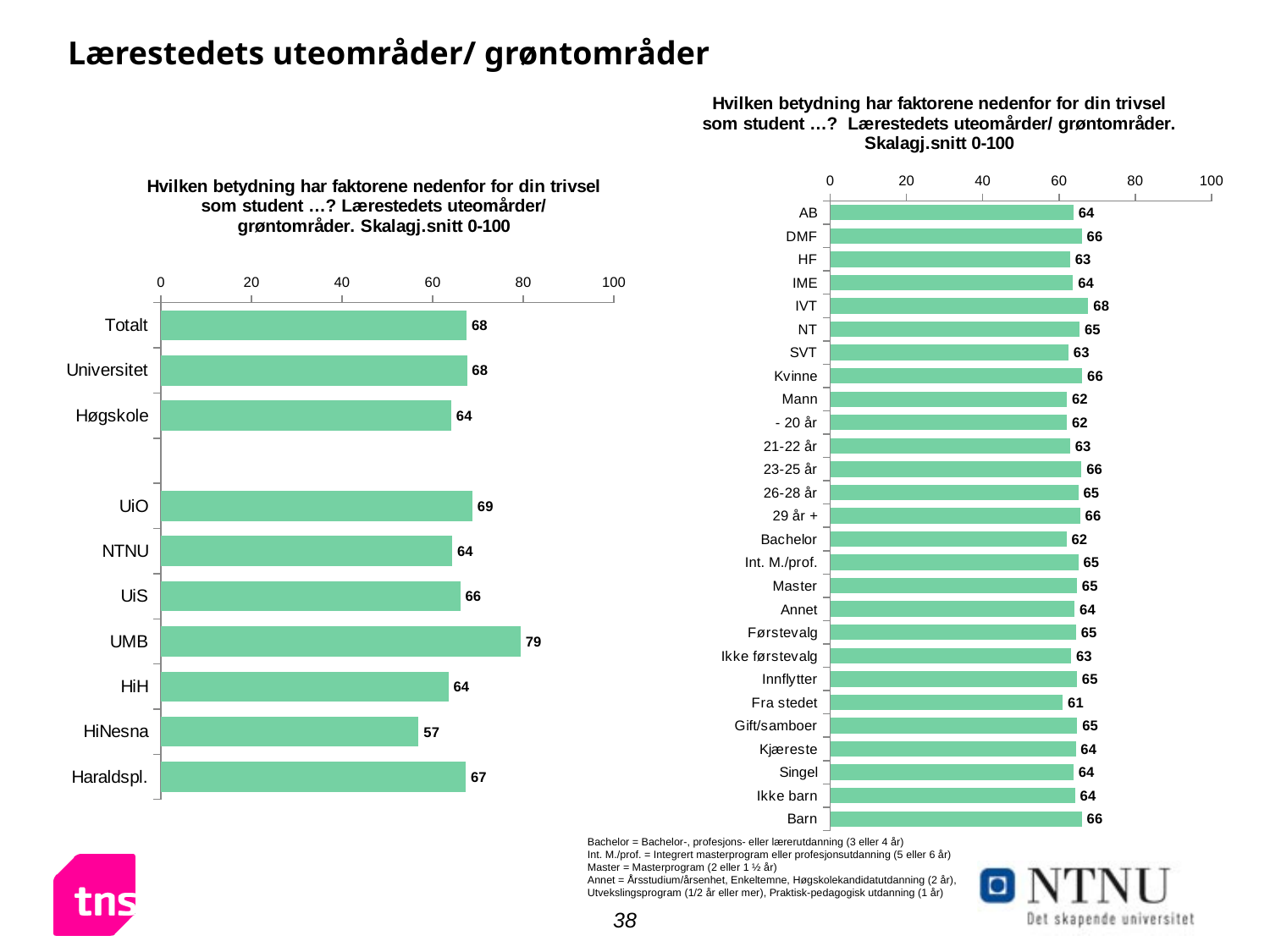
In the right chart, what is the difference between the values for Kvinne and Mann? 4 In the left chart, what is the value for UMB? 79 In the left chart, which is larger, the value for UiO or the value for NTNU? UiO In the left chart, what is the difference between the values for UMB and HiNesna? 22 In the right chart, which category has the highest value? IVT In the right chart, what is the value for IVT? 68 In the left chart, which category has the lowest value? HiNesna In the left chart, how many categories are plotted? 10 What kind of chart is the left chart? Bar chart In the right chart, how many categories are plotted? 27 In the left chart, which category has the highest value? UMB In the right chart, which category has the lowest value? Fra stedet